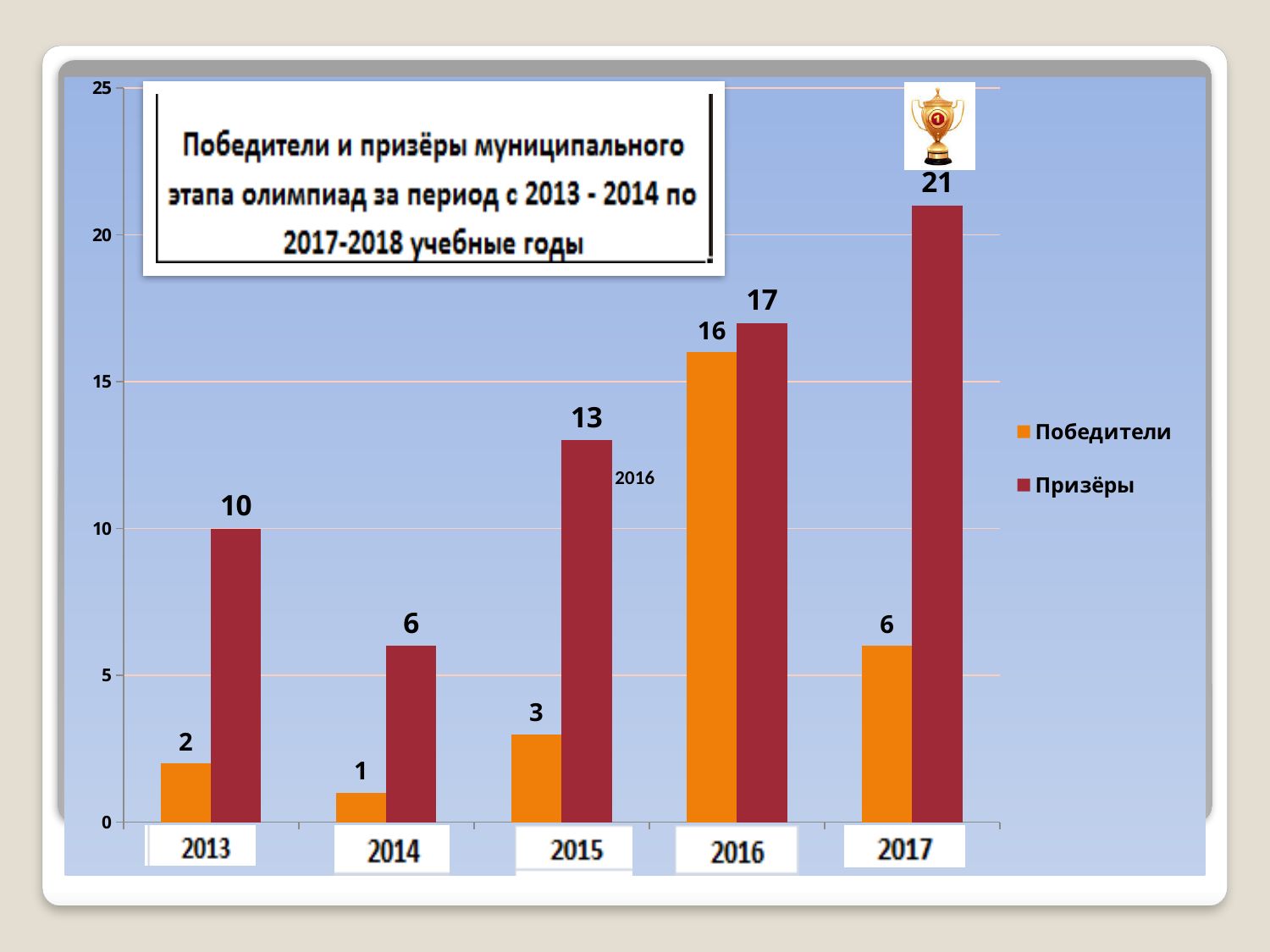
What is the value for Победители in 2014? 1 What is the value for Призёры in 2015? 13 What is the value for Призёры in 2017? 21 How many series does the legend list? 2 Which year has the lowest value for Победители? 2014 What is the difference between Призёры and Победители in 2013? 8 What kind of chart is shown on the slide? Bar chart Which series is shown in orange according to the legend? Победители Which year has the highest value for Призёры? 2017 How many years are shown on the x axis? 5 Which is larger: Победители in 2016 or Победители in 2017? Победители in 2016 What is the value for Победители in 2016? 16